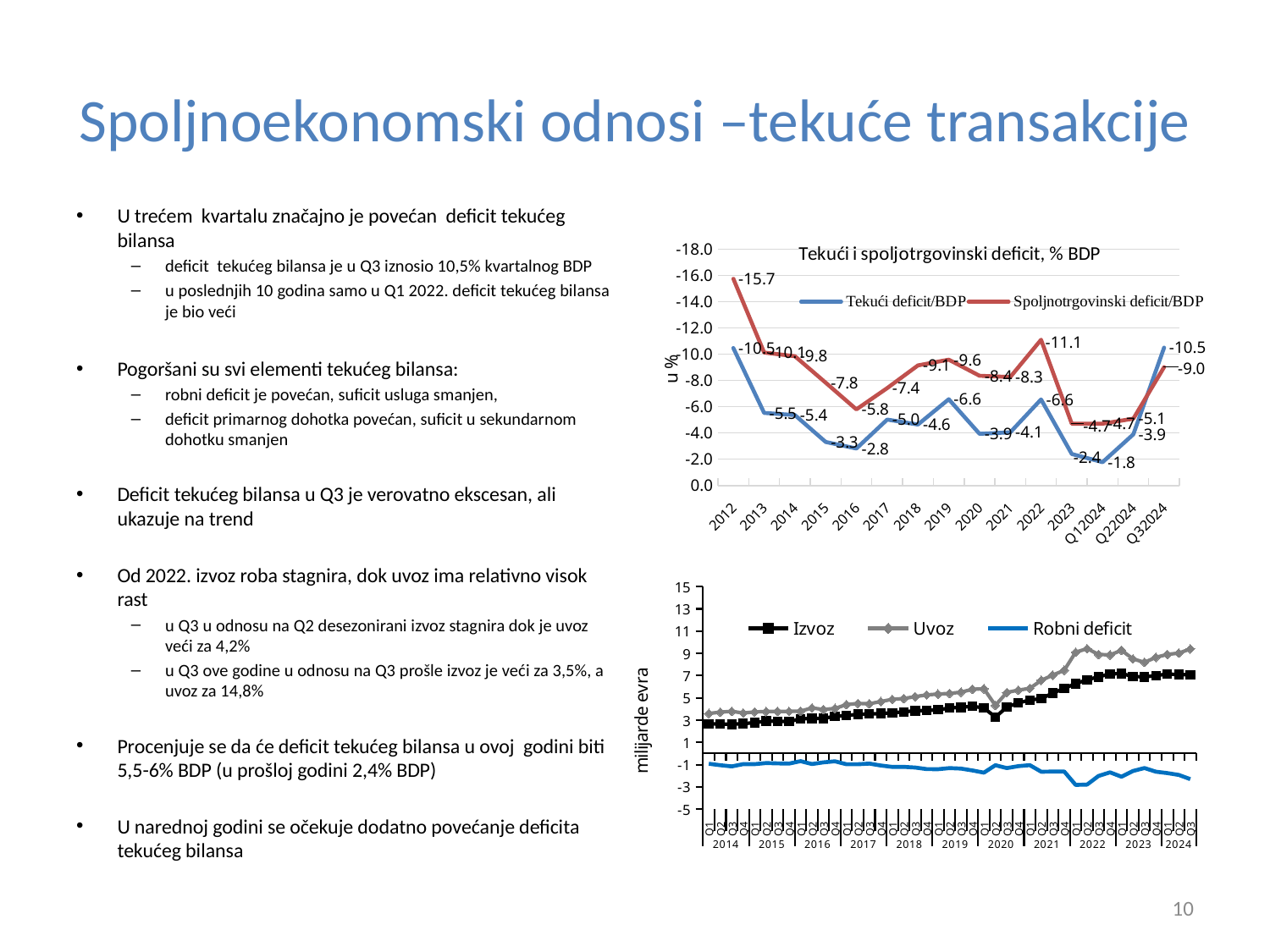
In the chart titled 'Tekući i spoljotrgovinski deficit, % BDP', what is the value of Spoljnotrgovinski deficit/BDP for 2012? -15.7 In the bottom chart, is the value of Uvoz for Q1 2014 greater or less than 5? less In the bottom chart, how many series does the legend list? 3 In the chart titled 'Tekući i spoljotrgovinski deficit, % BDP', what is the value of Tekući deficit/BDP for Q32024? -10.5 In the bottom chart, what unit is shown on the y axis? milijarde evra What kind of chart is the bottom chart on the slide (with Izvoz, Uvoz and Robni deficit)? line chart In the chart titled 'Tekući i spoljotrgovinski deficit, % BDP', what is the value of Tekući deficit/BDP for 2023? -2.4 In the chart titled 'Tekući i spoljotrgovinski deficit, % BDP', which series has the larger absolute value in 2019: Tekući deficit/BDP or Spoljnotrgovinski deficit/BDP? Spoljnotrgovinski deficit/BDP In the chart titled 'Tekući i spoljotrgovinski deficit, % BDP', what is the value of Spoljnotrgovinski deficit/BDP for 2022? -11.1 In the chart titled 'Tekući i spoljotrgovinski deficit, % BDP', how many series does the legend list? 2 In the chart titled 'Tekući i spoljotrgovinski deficit, % BDP', what is the difference between the Spoljnotrgovinski deficit/BDP and Tekući deficit/BDP values for 2016? 3.0 In the chart titled 'Tekući i spoljotrgovinski deficit, % BDP', how many points are plotted along the x axis? 15